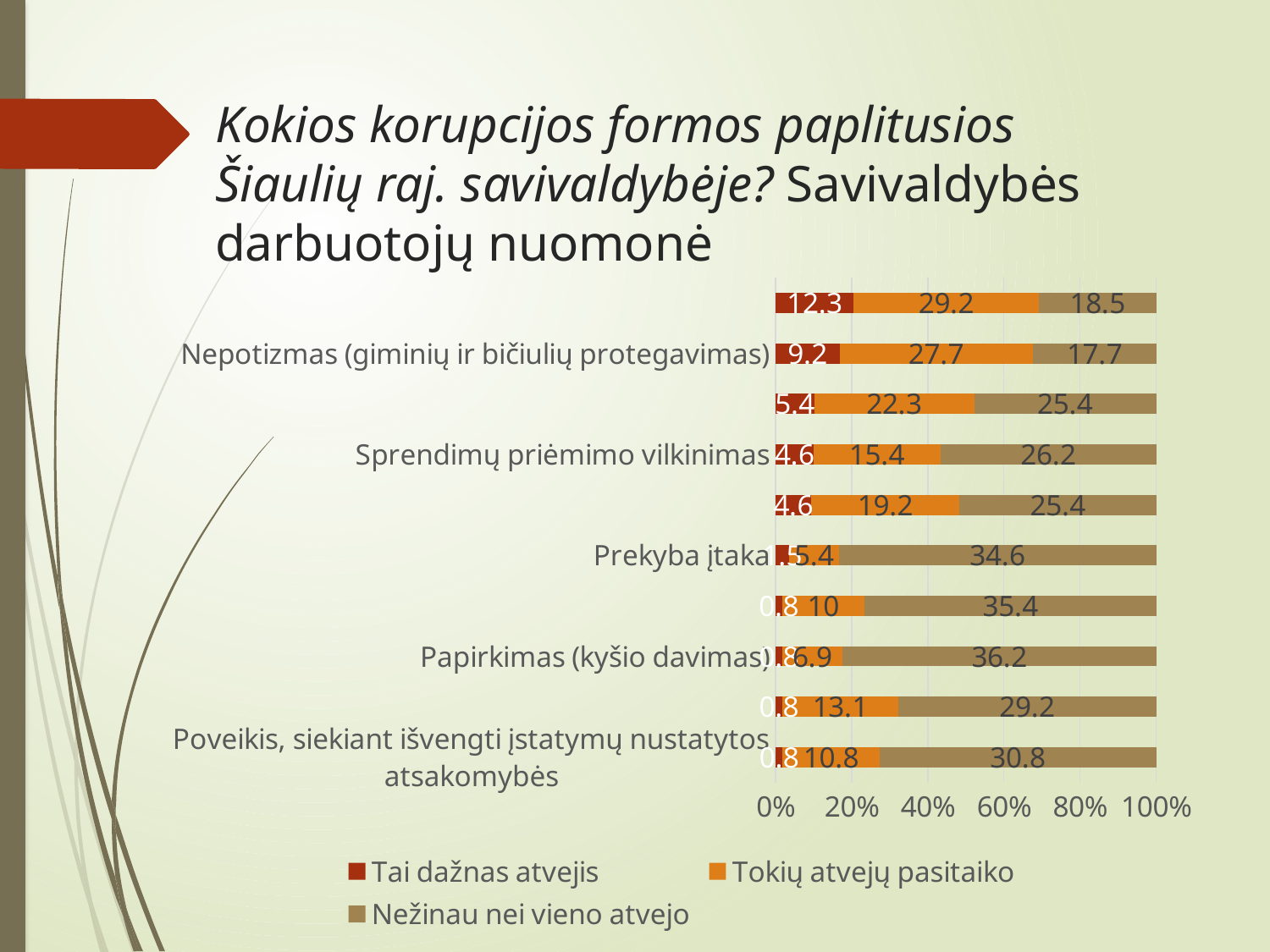
Which is larger for 'Tokių atvejų pasitaiko': 'Nepotizmas (giminių ir bičiulių protegavimas)' or 'Sprendimų priėmimo vilkinimas'? Nepotizmas (giminių ir bičiulių protegavimas) What is the value of 'Tokių atvejų pasitaiko' for 'Poveikis, siekiant išvengti įstatymų nustatytos atsakomybės'? 10.8 What type of chart is shown on the slide? stacked bar chart What is the difference between the 'Tokių atvejų pasitaiko' values for 'Nepotizmas (giminių ir bičiulių protegavimas)' and 'Sprendimų priėmimo vilkinimas'? 12.3 What is the value of 'Nežinau nei vieno atvejo' for 'Papirkimas (kyšio davimas)'? 36.2 Which legend entry is shown in orange? Tokių atvejų pasitaiko What is the value of 'Tai dažnas atvejis' for 'Nepotizmas (giminių ir bičiulių protegavimas)'? 9.2 How many series does the legend list? 3 What is the value of 'Tokių atvejų pasitaiko' for 'Nepotizmas (giminių ir bičiulių protegavimas)'? 27.7 How many bars are plotted in the chart? 10 Which category has the highest value for 'Nežinau nei vieno atvejo'? Papirkimas (kyšio davimas) What is the value of 'Nežinau nei vieno atvejo' for 'Sprendimų priėmimo vilkinimas'? 26.2